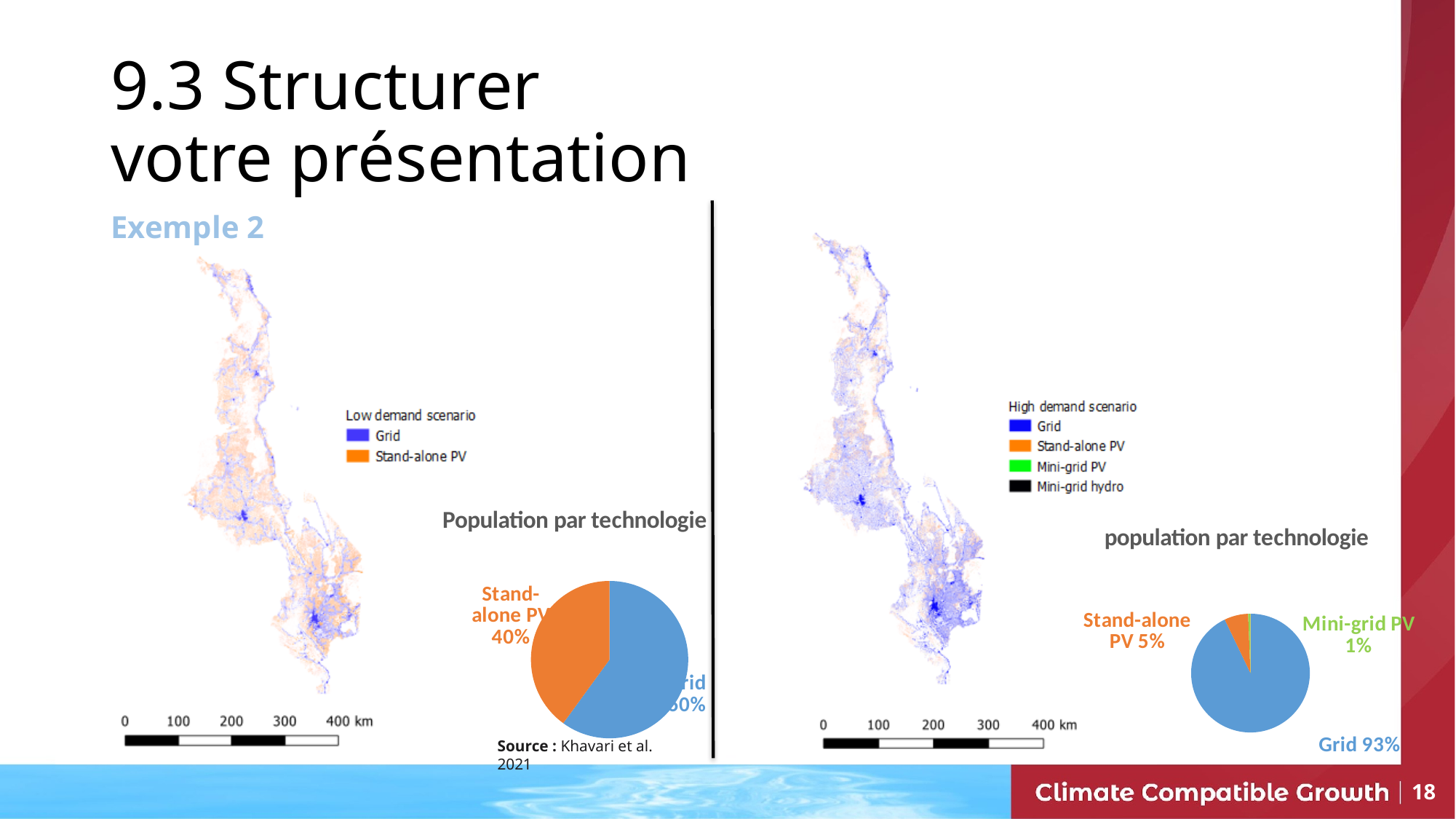
In the right pie chart 'population par technologie', which technology has the largest share? Grid In the right pie chart 'population par technologie', what share of the population is served by Grid? 93% What kind of chart is the 'Population par technologie' chart on the left side of the slide? pie chart In the right pie chart 'population par technologie', which labelled technology has the smallest share? Mini-grid PV In the right pie chart 'population par technologie', what is the difference between the Grid share and the Stand-alone PV share? 88% How many technologies are listed in the 'High demand scenario' map legend on the right side of the slide? 4 In the right pie chart 'population par technologie', which is larger, Stand-alone PV or Mini-grid PV? Stand-alone PV In the left pie chart 'Population par technologie', what share of the population is served by Stand-alone PV? 40% What colour is the Grid slice in the right pie chart 'population par technologie'? blue In the right pie chart 'population par technologie', what share of the population is served by Mini-grid PV? 1% In the left pie chart 'Population par technologie', which slice is larger, Grid or Stand-alone PV? Grid